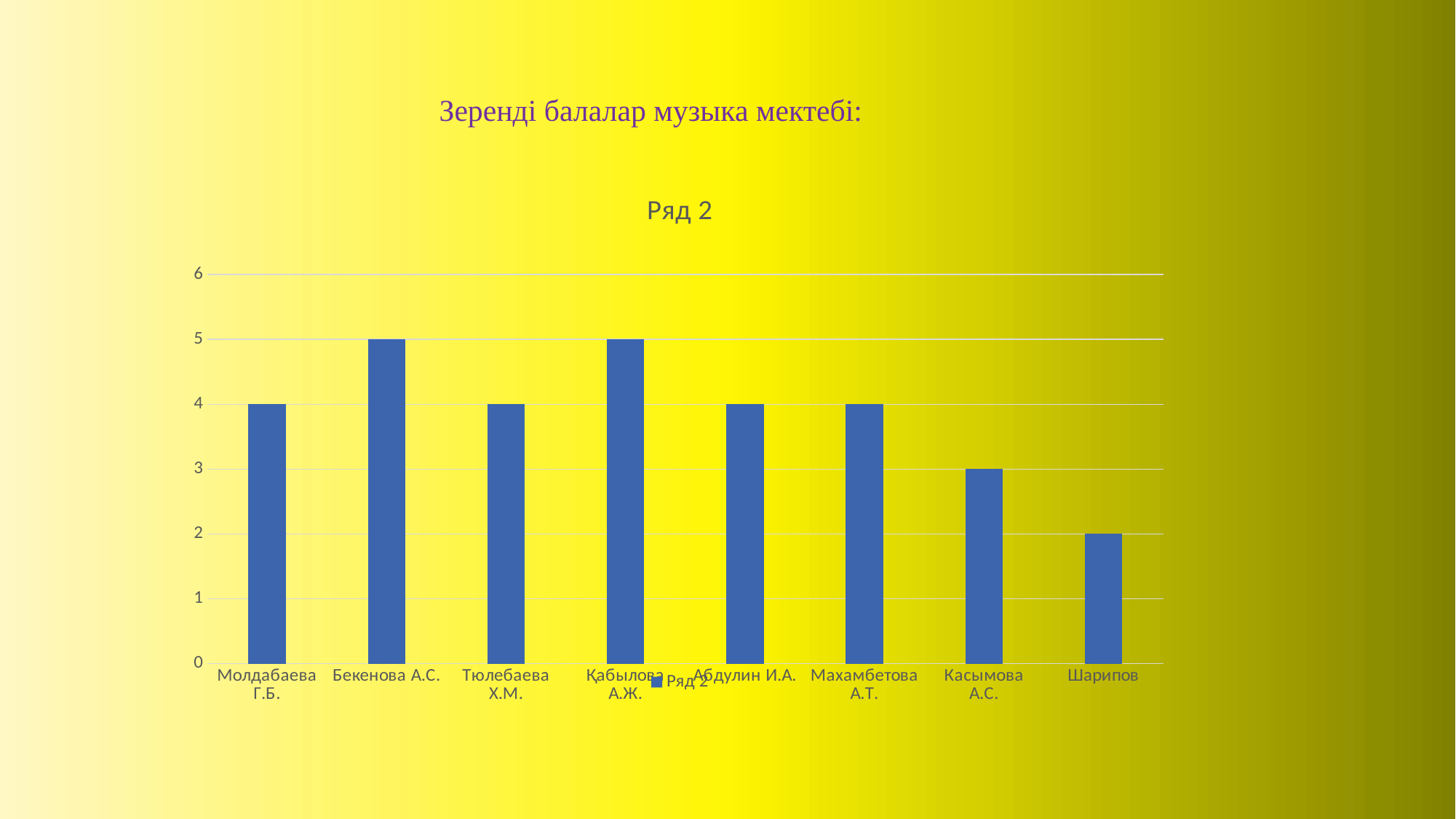
What is the value for Шарипов? 2 Which category has the lowest value? Шарипов What is the value for Молдабаева Г.Б.? 4 Which is larger, the value for Бекенова А.С. or the value for Касымова А.С.? Бекенова А.С. What is the difference between the values for Қабылова А.Ж. and Шарипов? 3 How many categories are shown on the x axis? 8 What is the value for Бекенова А.С.? 5 What is the title of the chart? Ряд 2 What is the value for Касымова А.С.? 3 Is the value for Абдулин И.А. greater or less than 3? greater How many series does the legend list? 1 What kind of chart is shown on the slide? bar chart